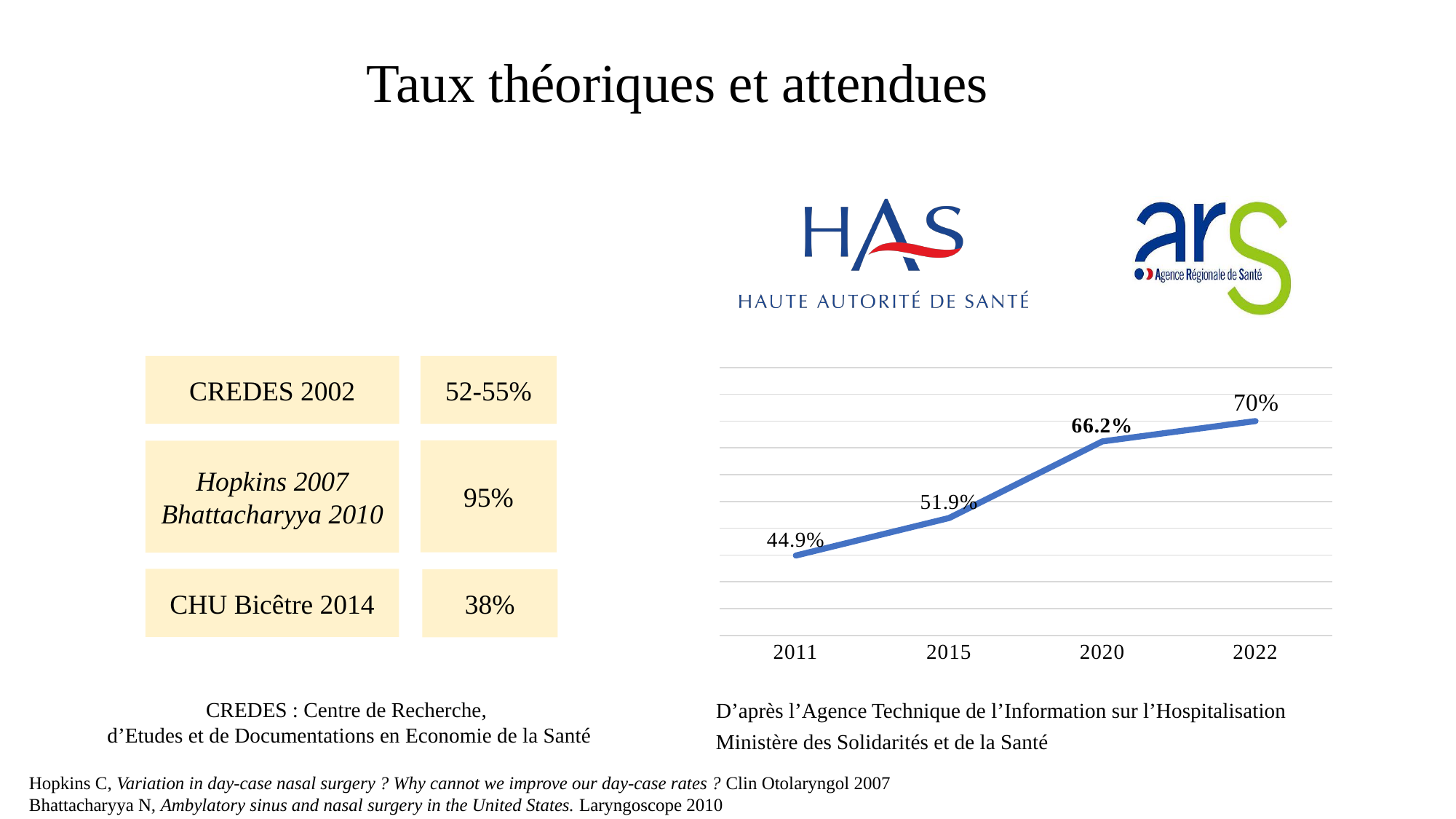
What is the value plotted for 2015 on the line chart? 51.9% How many data points are plotted on the line chart? 4 What is the value plotted for 2020 on the line chart? 66.2% What is the difference between the values for 2020 and 2015 on the line chart? 14.3% Do the values on the line chart rise or fall from 2011 to 2022? Rise What is the value plotted for 2022 on the line chart? 70% Which is larger on the line chart, the value for 2015 or the value for 2020? 2020 What kind of chart is shown on the slide? Line chart Which year has the lowest value on the line chart? 2011 Which year has the highest value on the line chart? 2022 What is the value plotted for 2011 on the line chart? 44.9% What is the difference between the values for 2022 and 2011 on the line chart? 25.1%